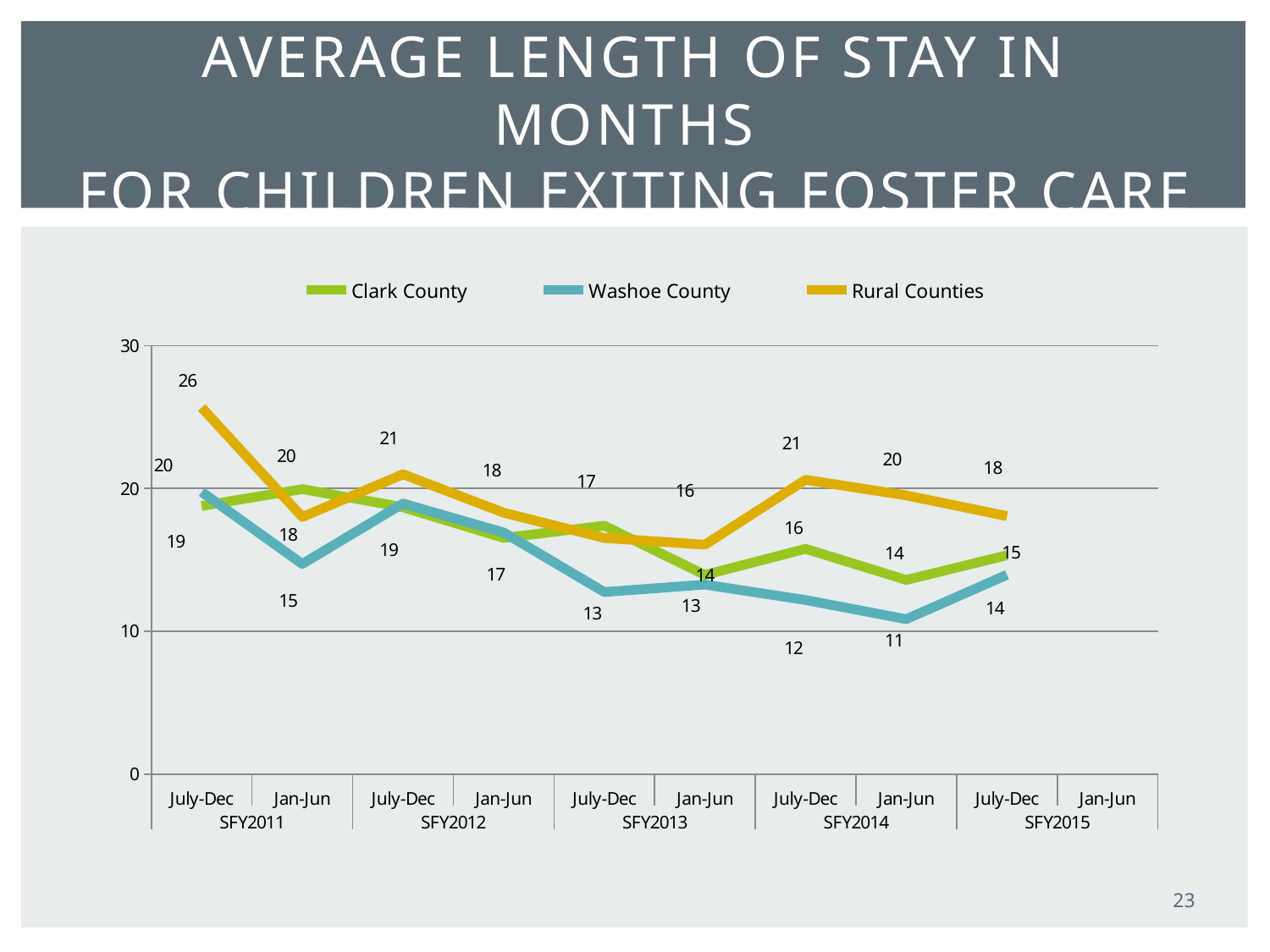
What is the value for Clark County in July-Dec SFY2014? 16 What kind of chart is shown on the slide? line chart What is the difference between Rural Counties and Washoe County in July-Dec SFY2014? 9 In Jan-Jun SFY2011, which is larger: Clark County or Washoe County? Clark County What is the value for Rural Counties in July-Dec SFY2015? 18 What is the value for Washoe County in Jan-Jun SFY2014? 11 What is the average length of stay for Rural Counties in July-Dec SFY2011? 26 Which series has the lowest value on the chart, and in which period? Washoe County, Jan-Jun SFY2014 Which colour represents Rural Counties in the legend? orange How many series does the legend list? 3 Which series has the highest value on the chart, and in which period? Rural Counties, July-Dec SFY2011 Does the Washoe County line generally rise or fall from July-Dec SFY2011 to Jan-Jun SFY2014? fall